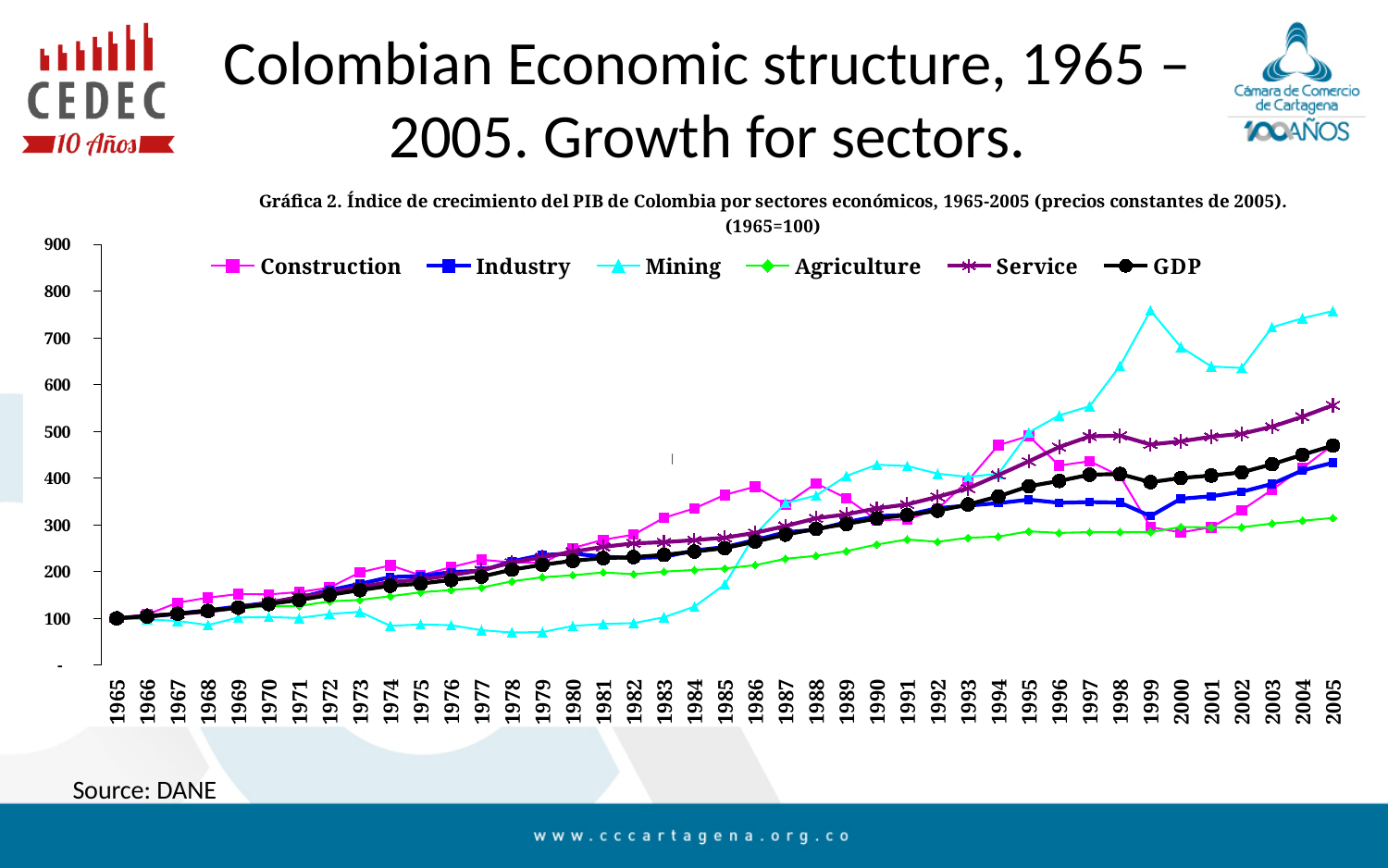
Which sector has the lowest index value in 2005? Agriculture Which sector has the highest index value in 2005? Mining Is the value for Agriculture in 2005 greater or less than 400? less Is the value for Service in 2005 greater or less than 500? greater Is the value for Mining in 1978 greater or less than 100? less Does the GDP line rise or fall from 1965 to 2005? Rise What kind of chart is shown on the slide? Line chart How many series does the legend list? 6 How many years are labelled along the x axis? 41 What base year is set to 100 according to the chart title? 1965 In 2005, which is larger: the Service index or the GDP index? Service